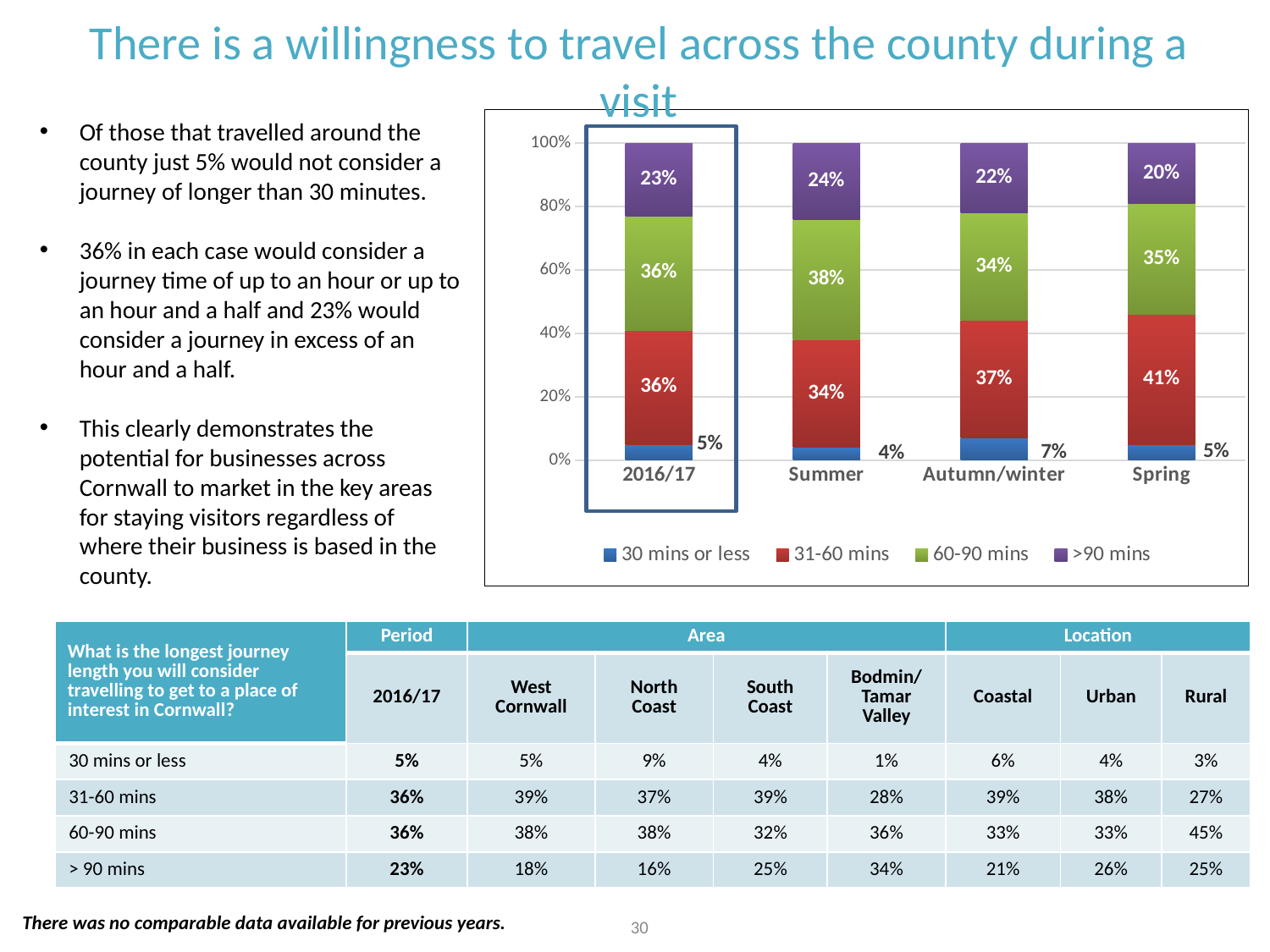
How many series does the chart legend list? 4 How many categories are shown along the x axis of the chart? 4 What is the value for '60-90 mins' in the 2016/17 bar? 36% Which category has the lowest value for '30 mins or less'? Summer Which category has the highest value for '31-60 mins'? Spring What is the difference between the '60-90 mins' values for Summer and Autumn/winter? 4% What is the value for '>90 mins' in the Summer bar? 24% What is the value for '31-60 mins' in the Spring bar? 41% Which series is shown in green in the chart? 60-90 mins Which is larger: the '>90 mins' value for 2016/17 or for Spring? 2016/17 What is the value for '30 mins or less' in the Autumn/winter bar? 7% What kind of chart is shown on the slide? Stacked bar chart